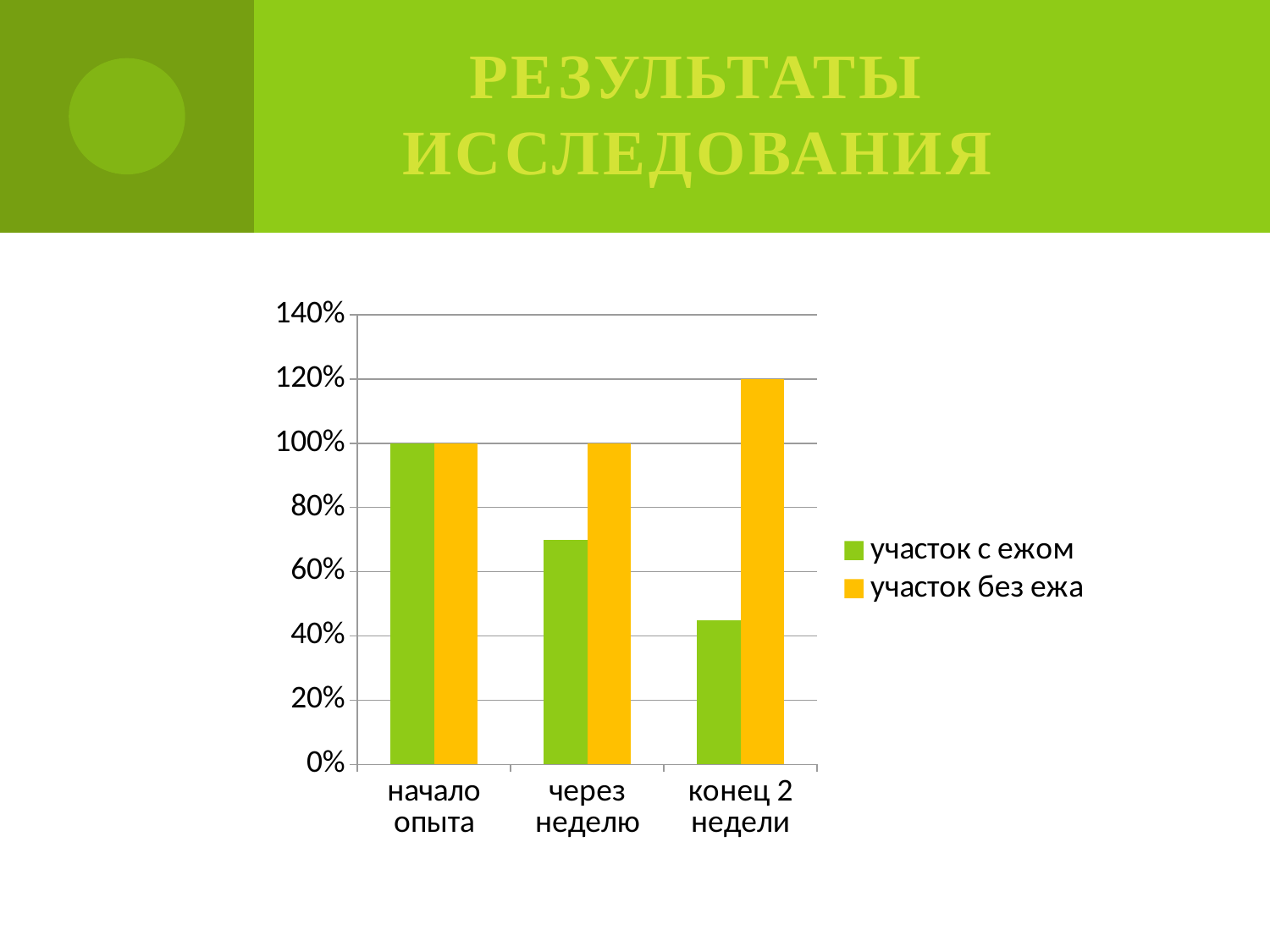
What is the value for участок без ежа at через неделю? 100% For участок с ежом, which category has the lowest value? конец 2 недели What kind of chart is shown on the slide? bar chart Is the value for участок с ежом at через неделю greater or less than 80%? less Do the values for участок с ежом rise or fall from начало опыта to конец 2 недели? fall At конец 2 недели, which series has the larger value, участок с ежом or участок без ежа? участок без ежа How many series does the legend list? 2 What is the value for участок без ежа at конец 2 недели? 120% What is the value for участок с ежом at начало опыта? 100% What is the difference between the value for участок без ежа at конец 2 недели and at начало опыта? 20% Is the value for участок с ежом at конец 2 недели greater or less than 40%? greater How many categories are shown on the x axis? 3